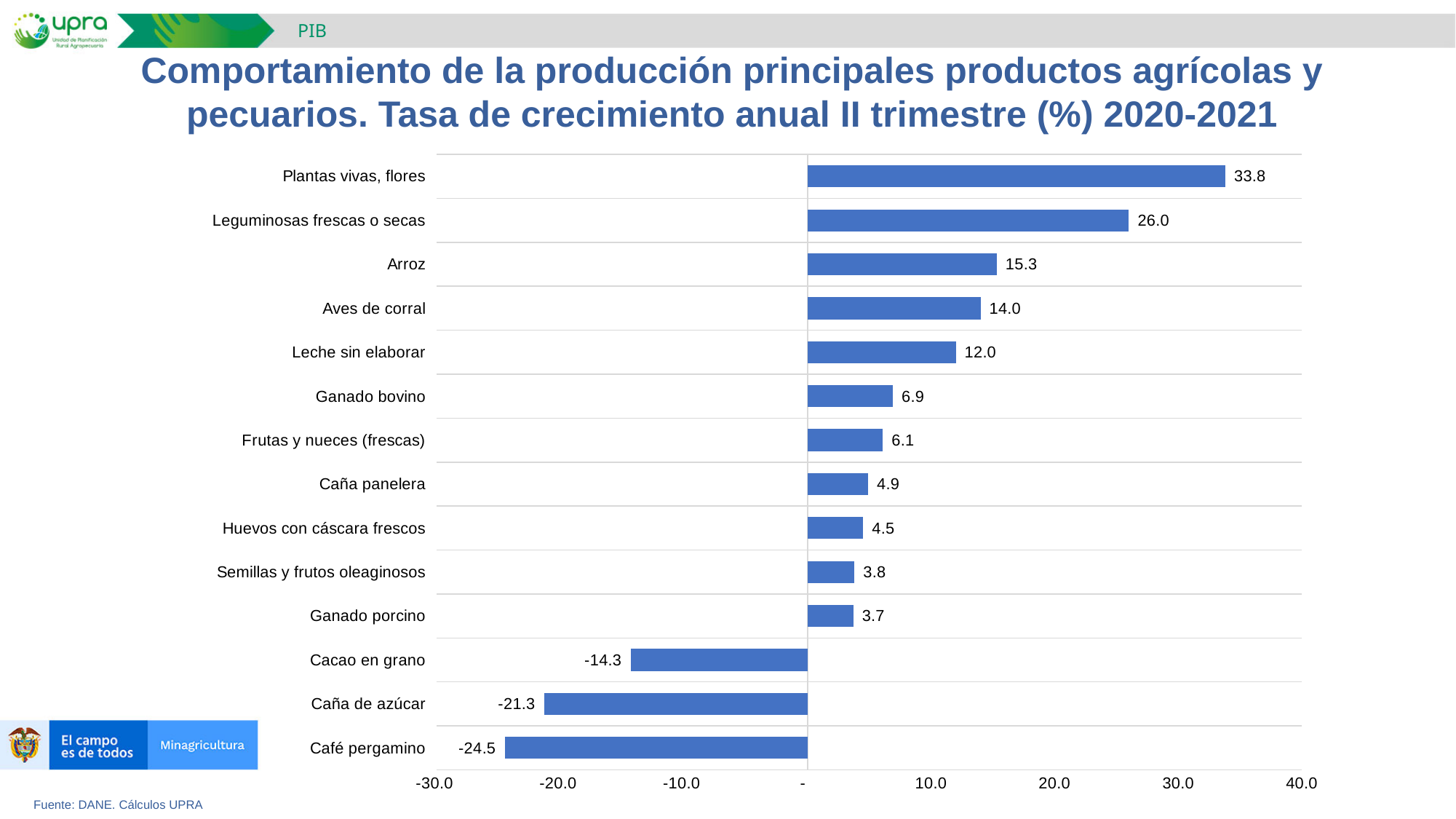
Which category has the highest value? Plantas vivas, flores Is the value for Leguminosas frescas o secas greater or less than 20.0? greater Which is larger, the value for Aves de corral or the value for Ganado bovino? Aves de corral What is the source cited below the chart? Fuente: DANE. Cálculos UPRA What is the value for Café pergamino? -24.5 What is the value for Leche sin elaborar? 12.0 What is the difference between the values for Plantas vivas, flores and Leguminosas frescas o secas? 7.8 How many categories are shown in the chart? 14 How many categories have negative values? 3 Which category has the lowest value? Café pergamino What is the value for Arroz? 15.3 What kind of chart is shown on the slide? Bar chart